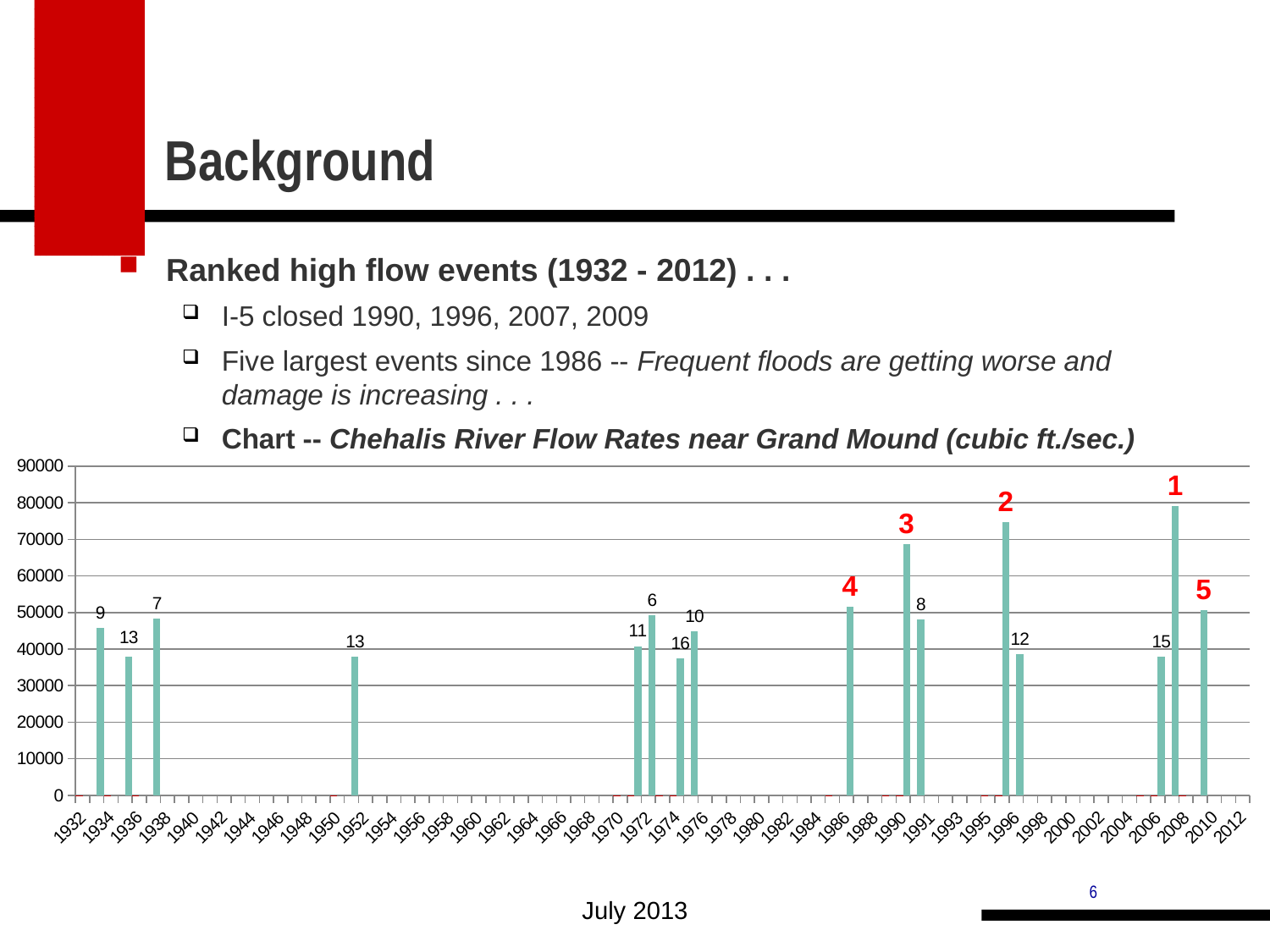
Which rank label is shown above the tallest bar in the chart? 1 How many bars are plotted in the chart? 16 Which bar is taller, the one labelled 2 or the one labelled 3? the one labelled 2 Is the value of the bar labelled 3 greater or less than 70000? less What is the title of the chart on the slide? Chehalis River Flow Rates near Grand Mound (cubic ft./sec.) Is the value of the bar labelled 2 greater or less than 70000? greater Is the value of the bar labelled 16 greater or less than 40000? less What kind of chart is shown on the slide? bar chart What is the highest value shown on the chart's vertical axis? 90000 Which bar is taller, the one labelled 1 or the one labelled 5? the one labelled 1